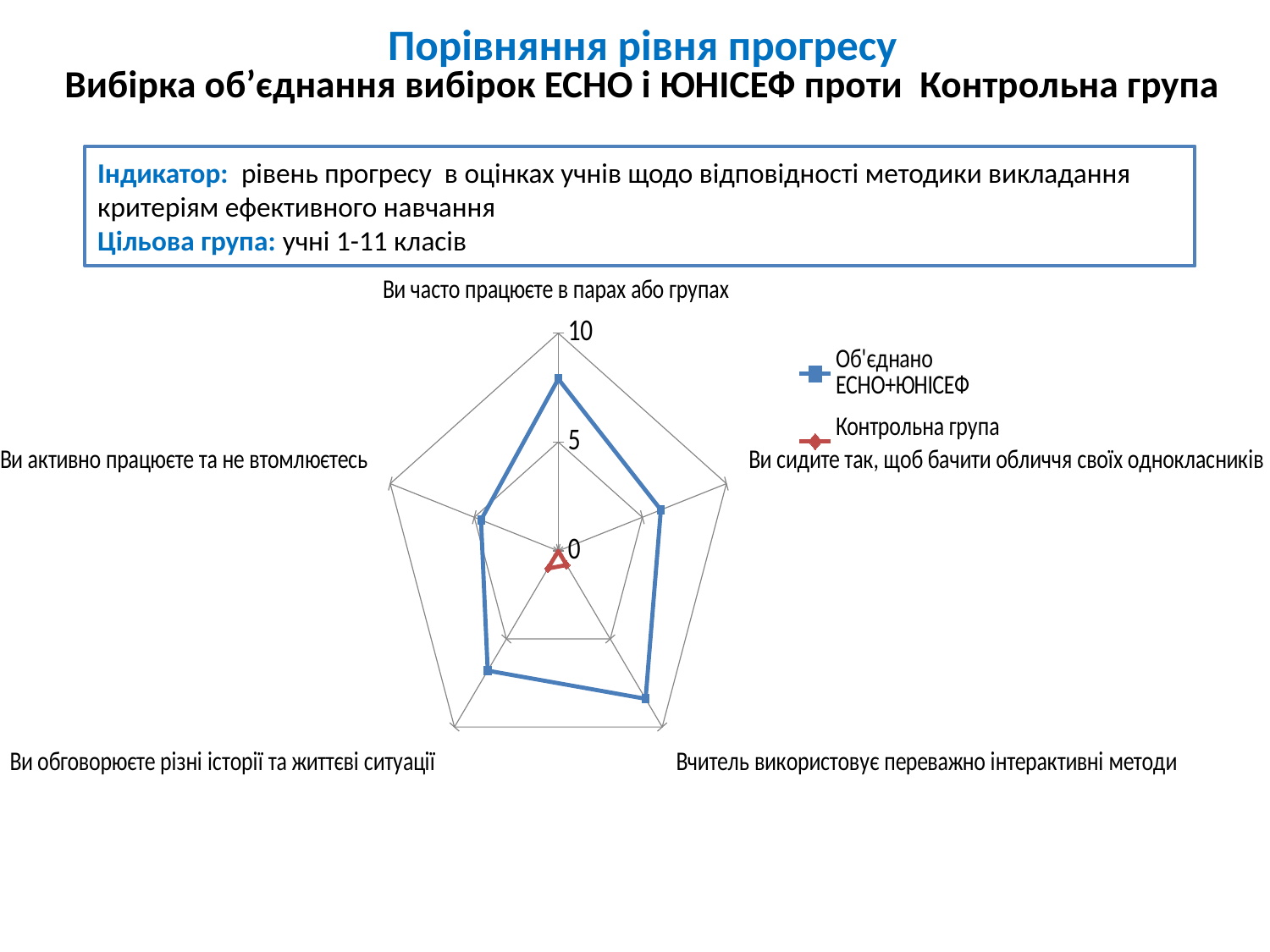
Is the value of the Об'єднано ECHO+ЮНІСЕФ series for "Вчитель використовує переважно інтерактивні методи" greater or less than 5? greater How many categories (axes) does the radar chart have? 5 How many series does the chart legend list? 2 Which colour is used for the Контрольна група series? Red Is the value of the Об'єднано ECHO+ЮНІСЕФ series for "Ви часто працюєте в парах або групах" greater or less than 5? greater Is the value of the Об'єднано ECHO+ЮНІСЕФ series for "Ви обговорюєте різні історії та життєві ситуації" greater or less than 5? greater Which series has the larger value for "Ви часто працюєте в парах або групах": Об'єднано ECHO+ЮНІСЕФ or Контрольна група? Об'єднано ECHO+ЮНІСЕФ For the Об'єднано ECHO+ЮНІСЕФ series, which category has the lowest value? Ви активно працюєте та не втомлюєтесь Which series has the larger value for "Ви активно працюєте та не втомлюєтесь": Об'єднано ECHO+ЮНІСЕФ or Контрольна група? Об'єднано ECHO+ЮНІСЕФ What kind of chart is shown on the slide? Radar chart What is the maximum value shown on the radar chart's axis scale? 10